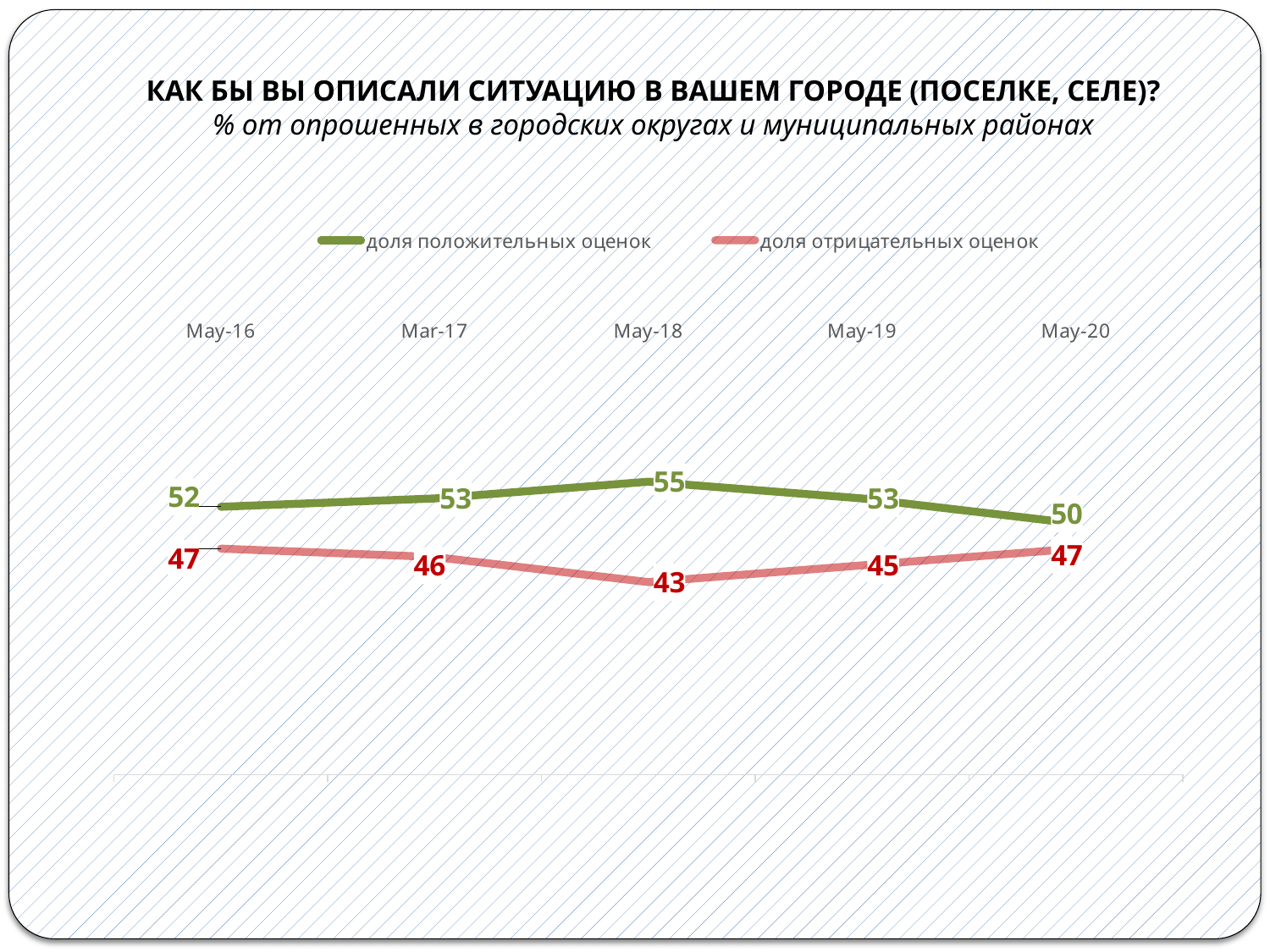
What is the difference between 'доля положительных оценок' in May-18 and in May-20? 5 Which is larger in May-19: 'доля положительных оценок' or 'доля отрицательных оценок'? доля положительных оценок What is the value of 'доля отрицательных оценок' for May-20? 47 What kind of chart is shown on the slide? line chart What is the difference between 'доля положительных оценок' and 'доля отрицательных оценок' in May-18? 12 At which date is 'доля отрицательных оценок' lowest? May-18 How many series does the legend list? 2 What is the value of 'доля отрицательных оценок' for Mar-17? 46 At which date is 'доля положительных оценок' lowest? May-20 At which date is 'доля положительных оценок' highest? May-18 How many time points are plotted on the x axis? 5 What is the value of 'доля положительных оценок' for May-18? 55